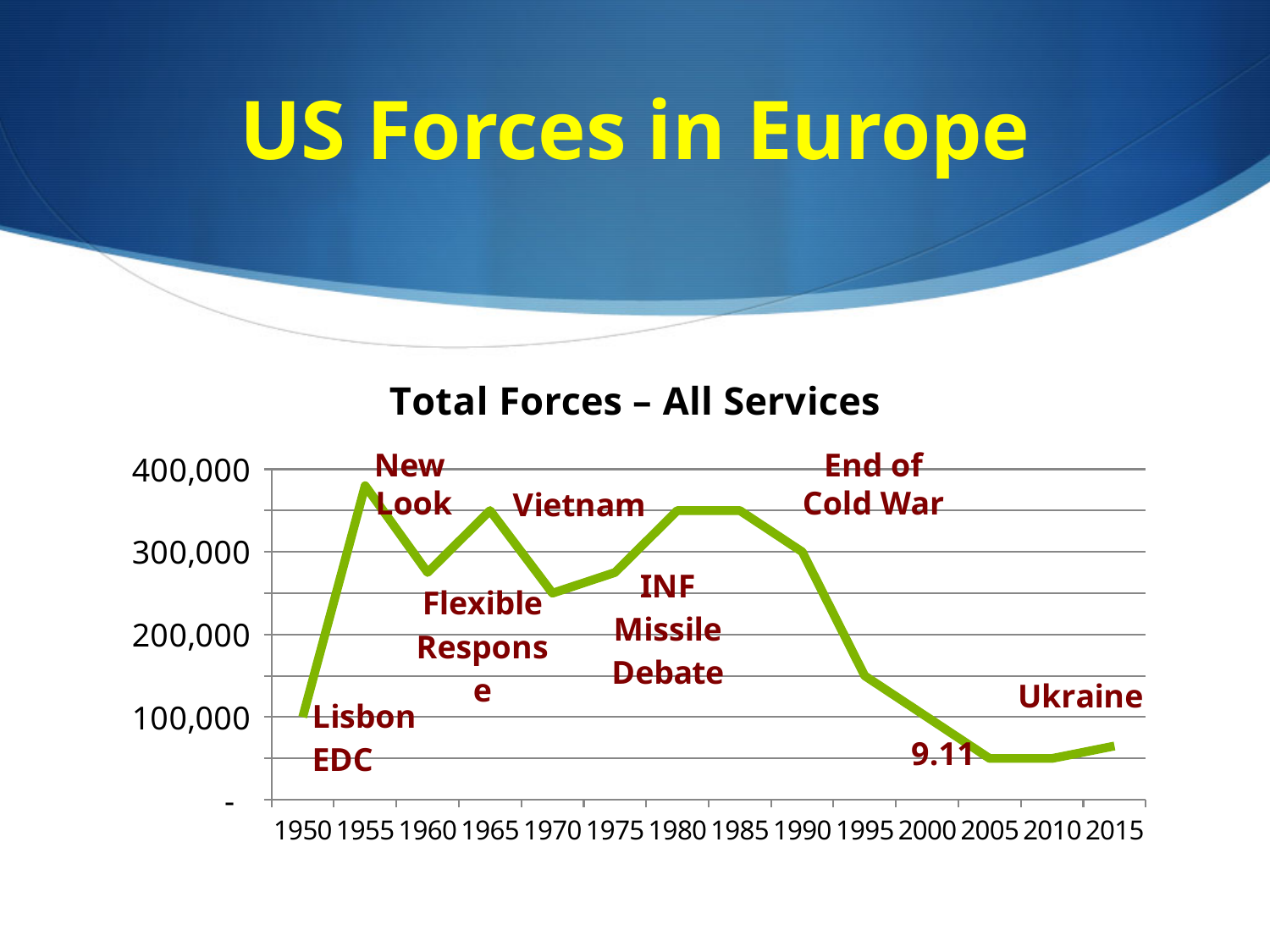
Is the value for 1955 greater or less than 300,000? greater What is the title of the chart? Total Forces – All Services Is the value for 1970 greater or less than 300,000? less What kind of chart is shown on the slide? line chart Is the value for 1995 greater or less than 200,000? less How many years are labelled along the x axis? 14 Which year has the larger value, 1985 or 1995? 1985 In which year does the line reach its highest value? 1955 Which year has the larger value, 1955 or 1960? 1955 Do the values rise or fall between 1985 and 2005? fall